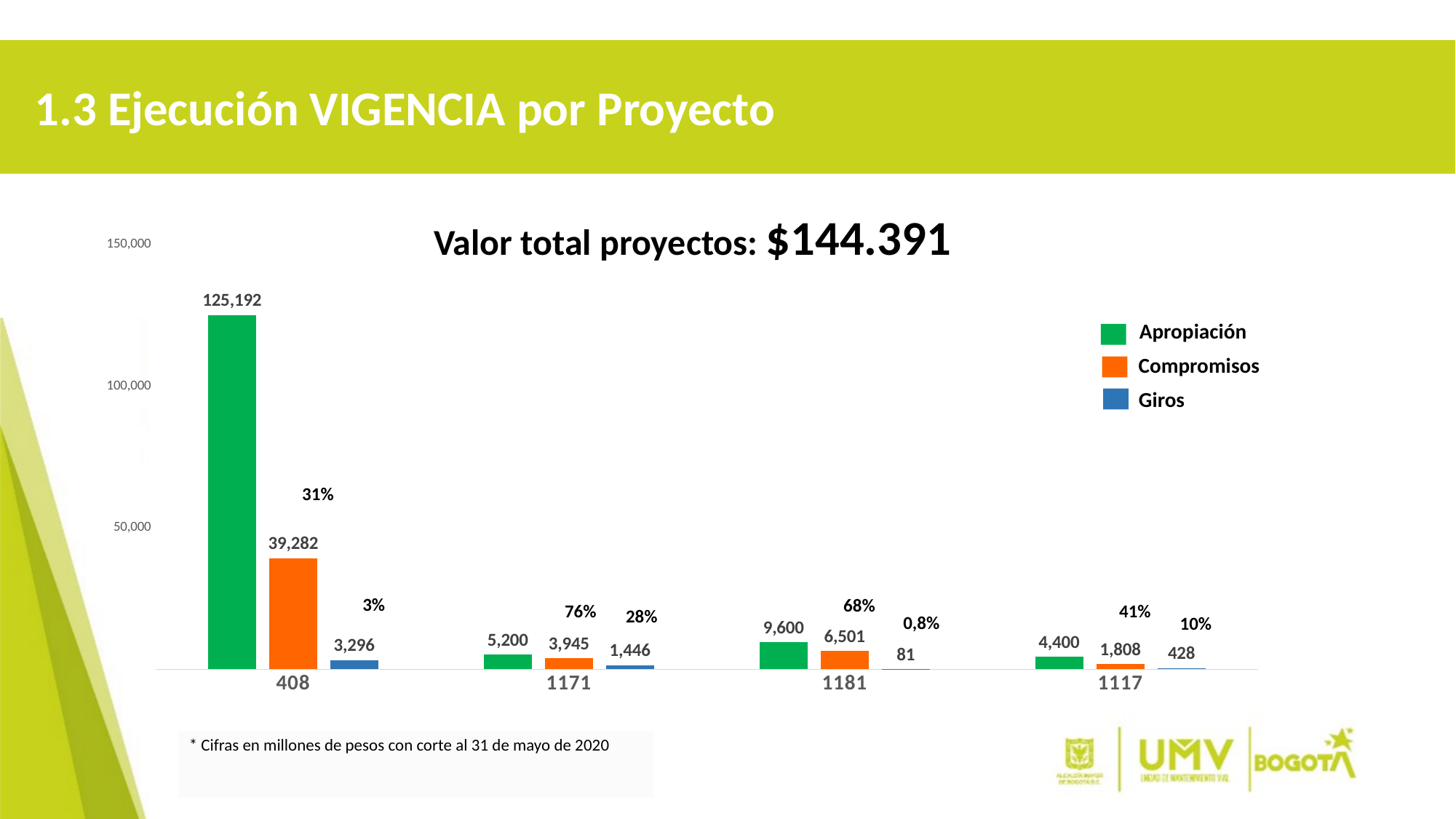
What is the Apropiación value for project 408? 125,192 Which project has the lowest Giros value? 1181 What is the difference between Apropiación and Compromisos for project 1171? 1,255 Which is larger, the Compromisos value for project 1171 or for project 1117? 1171 Is the Compromisos value for project 408 greater or less than 50,000? less How many projects are shown on the x axis? 4 What is the Compromisos value for project 1181? 6,501 What is the Giros value for project 1117? 428 How many series does the legend list? 3 What kind of chart is shown on the slide? bar chart What total value of projects is stated in the chart title? $144.391 Which project has the highest Apropiación value? 408